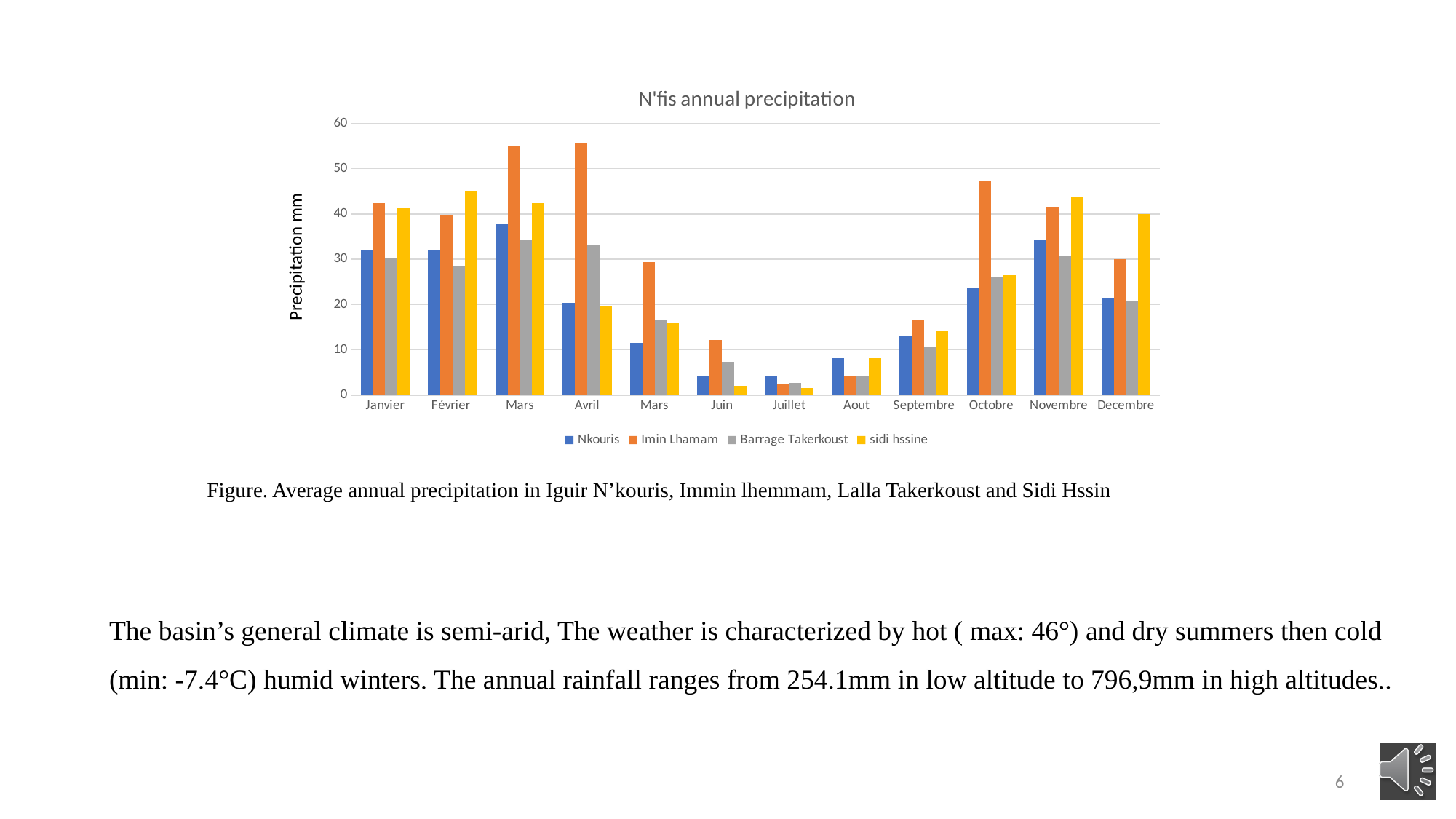
In which month is the value for Imin Lhamam lowest? Juillet Is the value for sidi hssine in Juin greater or less than 10? less What is the title of the chart? N'fis annual precipitation In Decembre, which is larger: sidi hssine or Imin Lhamam? sidi hssine Do the values for Nkouris rise or fall from Juillet to Novembre? rise Is the value for Imin Lhamam in Octobre greater or less than 40? greater Which series has the highest value in Avril? Imin Lhamam How many series does the legend list? 4 Is the value for Nkouris in Juillet greater or less than 10? less What kind of chart is shown on the slide? bar chart How many month categories are shown on the x axis? 12